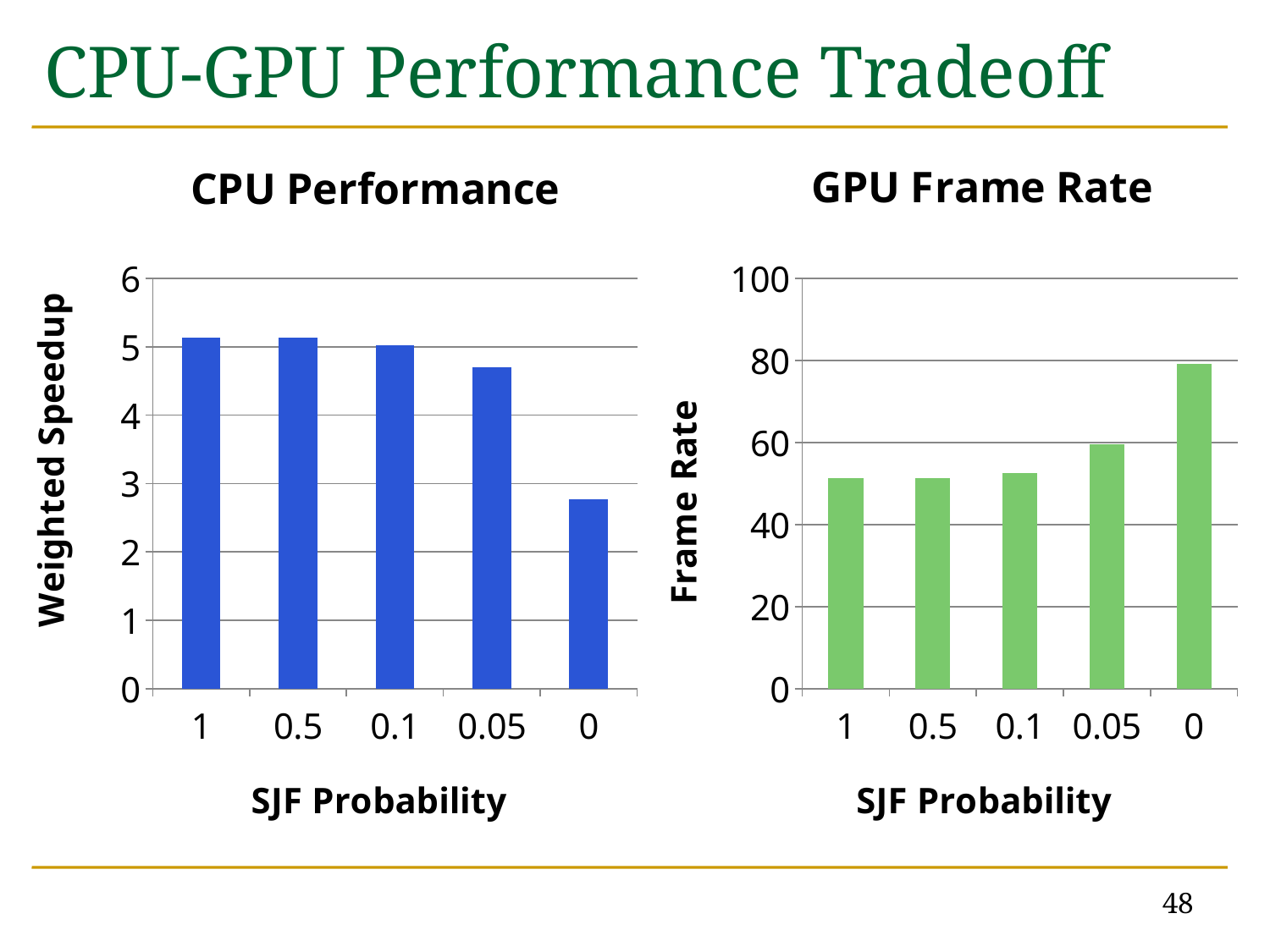
What is the y-axis title of the CPU Performance chart? Weighted Speedup On the CPU Performance chart, is the weighted speedup for SJF Probability 0 greater or less than 3? less On the CPU Performance chart, which is larger: the weighted speedup for SJF Probability 0.05 or for SJF Probability 0? 0.05 On the GPU Frame Rate chart, is the frame rate for SJF Probability 1 greater or less than 60? less On the GPU Frame Rate chart, is the frame rate for SJF Probability 0 greater or less than 60? greater What kind of chart is the CPU Performance chart? bar chart On the GPU Frame Rate chart, do the frame rate values rise or fall moving from SJF Probability 1 to 0 along the x axis? rise On the CPU Performance chart, which SJF Probability has the lowest weighted speedup? 0 On the GPU Frame Rate chart, which SJF Probability has the highest frame rate? 0 How many SJF Probability categories are shown on the GPU Frame Rate chart? 5 On the GPU Frame Rate chart, which is larger: the frame rate for SJF Probability 0.05 or for SJF Probability 0.1? 0.05